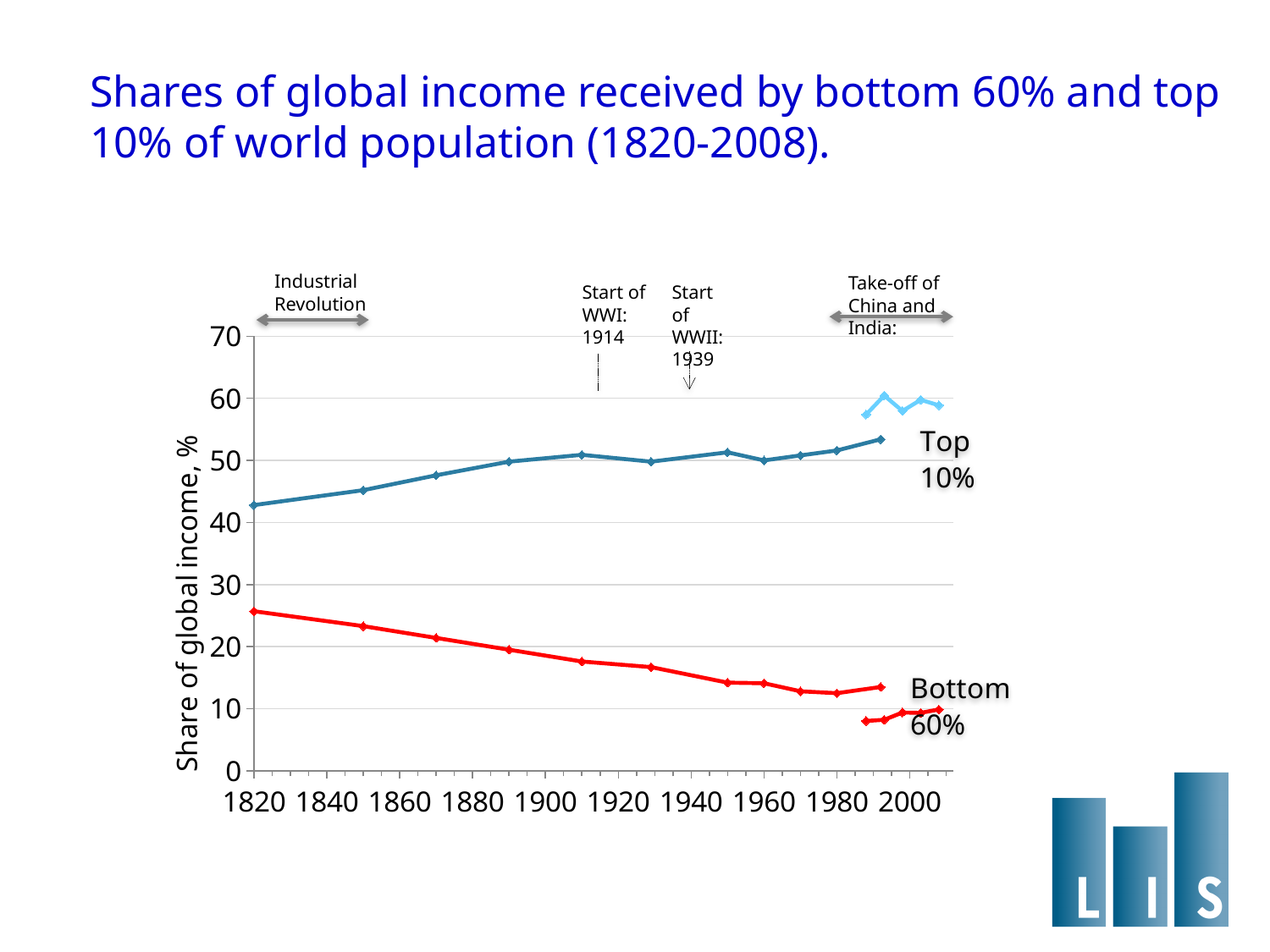
What is the label of the vertical axis? Share of global income, % Does the Bottom 60% series rise or fall from 1820 to 1980? fall What is the title of the slide's chart? Shares of global income received by bottom 60% and top 10% of world population (1820-2008). Is the value for Bottom 60% in 1820 greater or less than 20? greater Is the value for Top 10% in 1850 greater or less than 50? less Does the Top 10% series rise or fall from 1820 to 1910? rise In which year does the Bottom 60% series reach its highest value? 1820 Is the value for Bottom 60% in 1980 greater or less than 20? less What kind of chart is shown on the slide? line chart In which year does the Top 10% series have its lowest value? 1820 Which series has the larger value in 1900, Top 10% or Bottom 60%? Top 10%